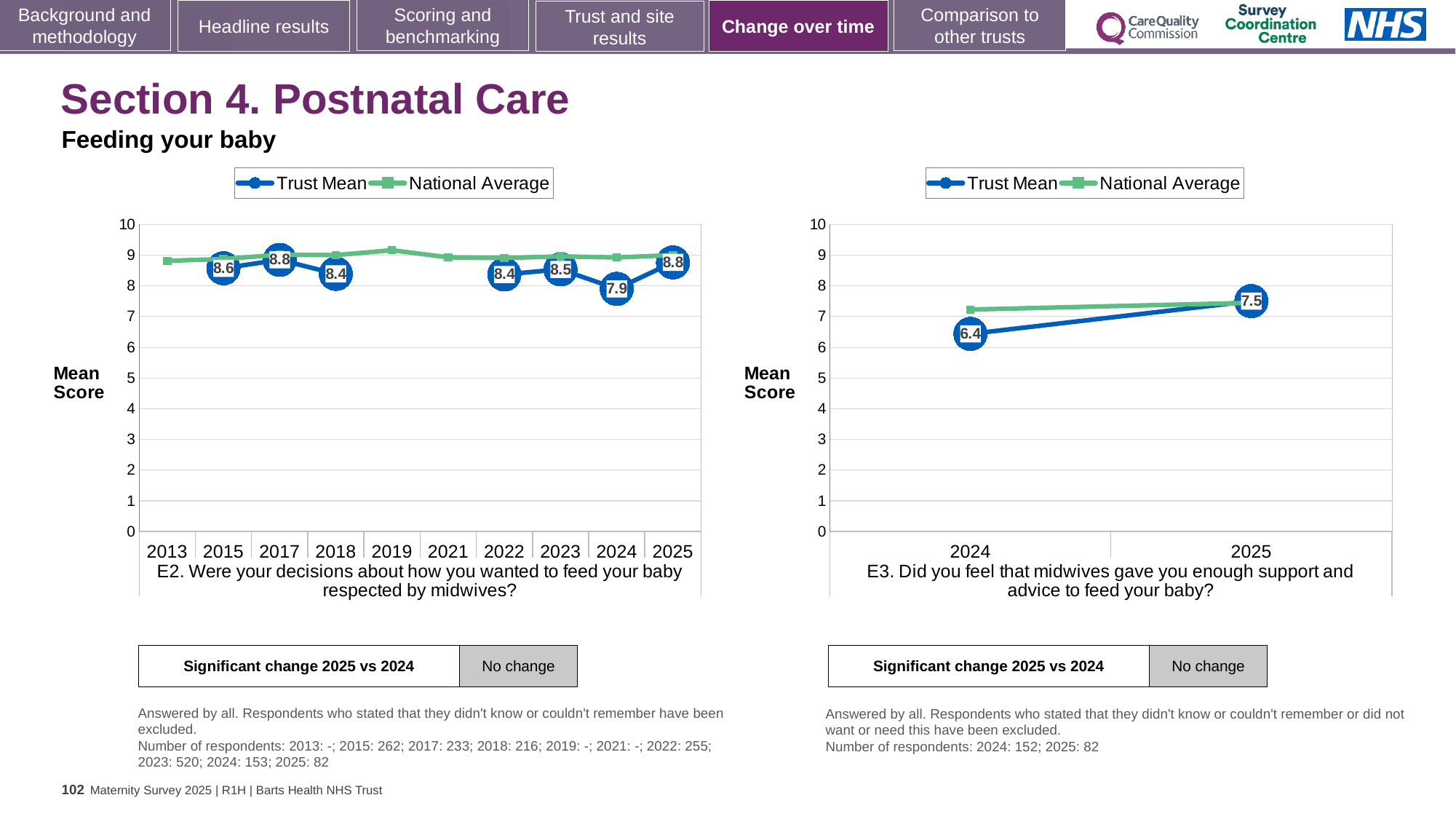
In the E2 chart (left), which is larger, the Trust Mean for 2023 or for 2024? 2023 In the E3 chart (right), what is the Trust Mean for 2025? 7.5 In the E3 chart (right), what is the Trust Mean for 2024? 6.4 How many years are shown on the x axis of the E2 chart (left)? 10 In the E2 chart (left), what is the difference between the Trust Mean for 2025 and 2024? 0.9 In the E2 chart (left), what is the Trust Mean for 2018? 8.4 How many series does the legend of the E3 chart (right) list? 2 What kind of chart is the E3 chart (right)? Line chart In the E3 chart (right), is the National Average for 2024 greater or less than 7? greater In the E2 chart (left), what is the Trust Mean for 2024? 7.9 In the E3 chart (right), what is the difference between the Trust Mean for 2025 and 2024? 1.1 In the E2 chart (left), which year has the lowest labelled Trust Mean? 2024